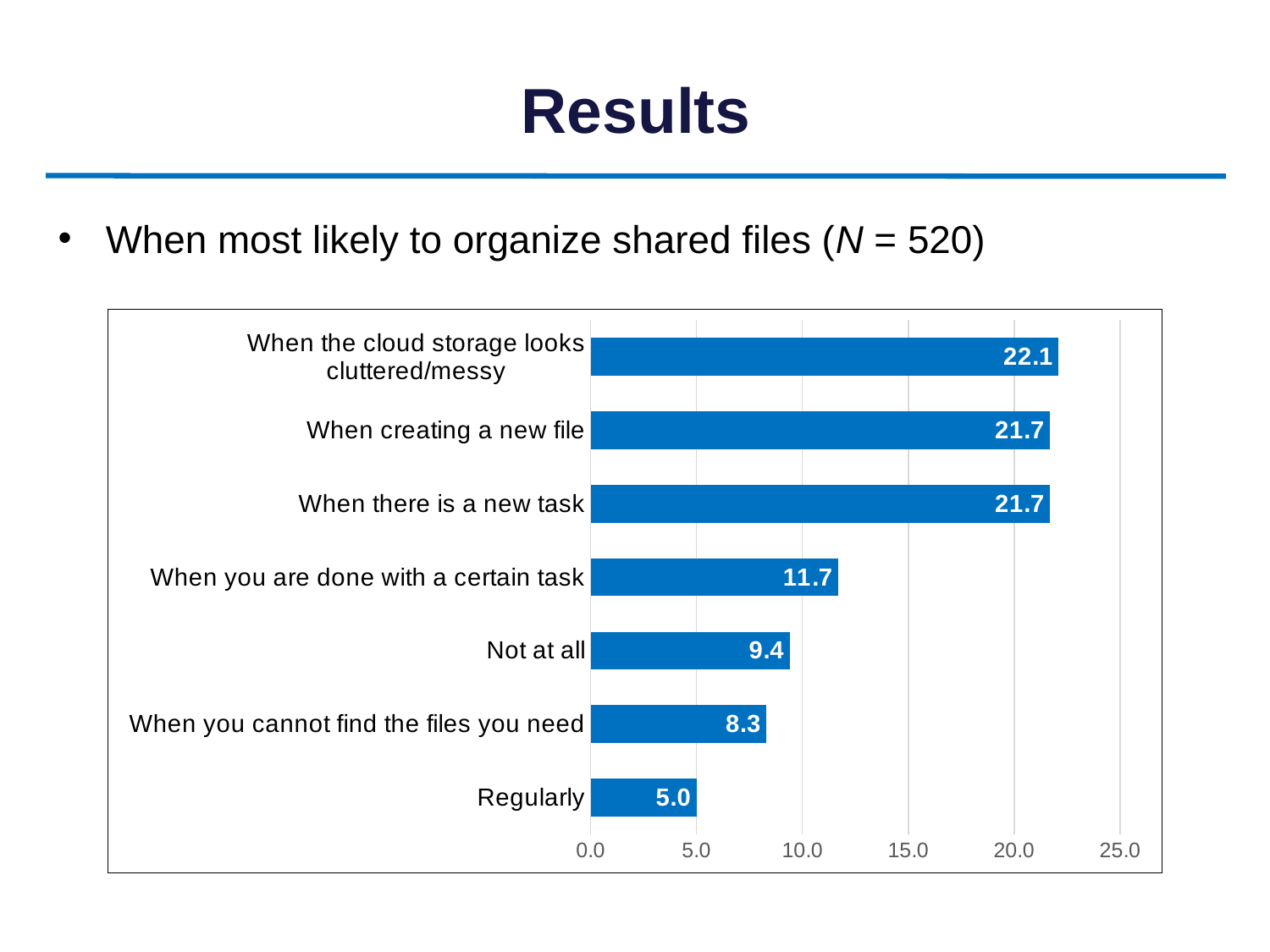
Which is larger, the value for "Not at all" or the value for "When you cannot find the files you need"? Not at all Which category has the lowest value? Regularly What kind of chart is shown on the slide? bar chart What is the value for "When creating a new file"? 21.7 What is the highest tick value shown on the horizontal axis? 25.0 Which category has the highest value? When the cloud storage looks cluttered/messy What is the difference between the values for "When you are done with a certain task" and "Regularly"? 6.7 Is the value for "When there is a new task" greater or less than 20.0? greater What is the value for "Regularly"? 5.0 What is the value for "Not at all"? 9.4 How many categories are shown in the chart? 7 What is the value for "When you cannot find the files you need"? 8.3